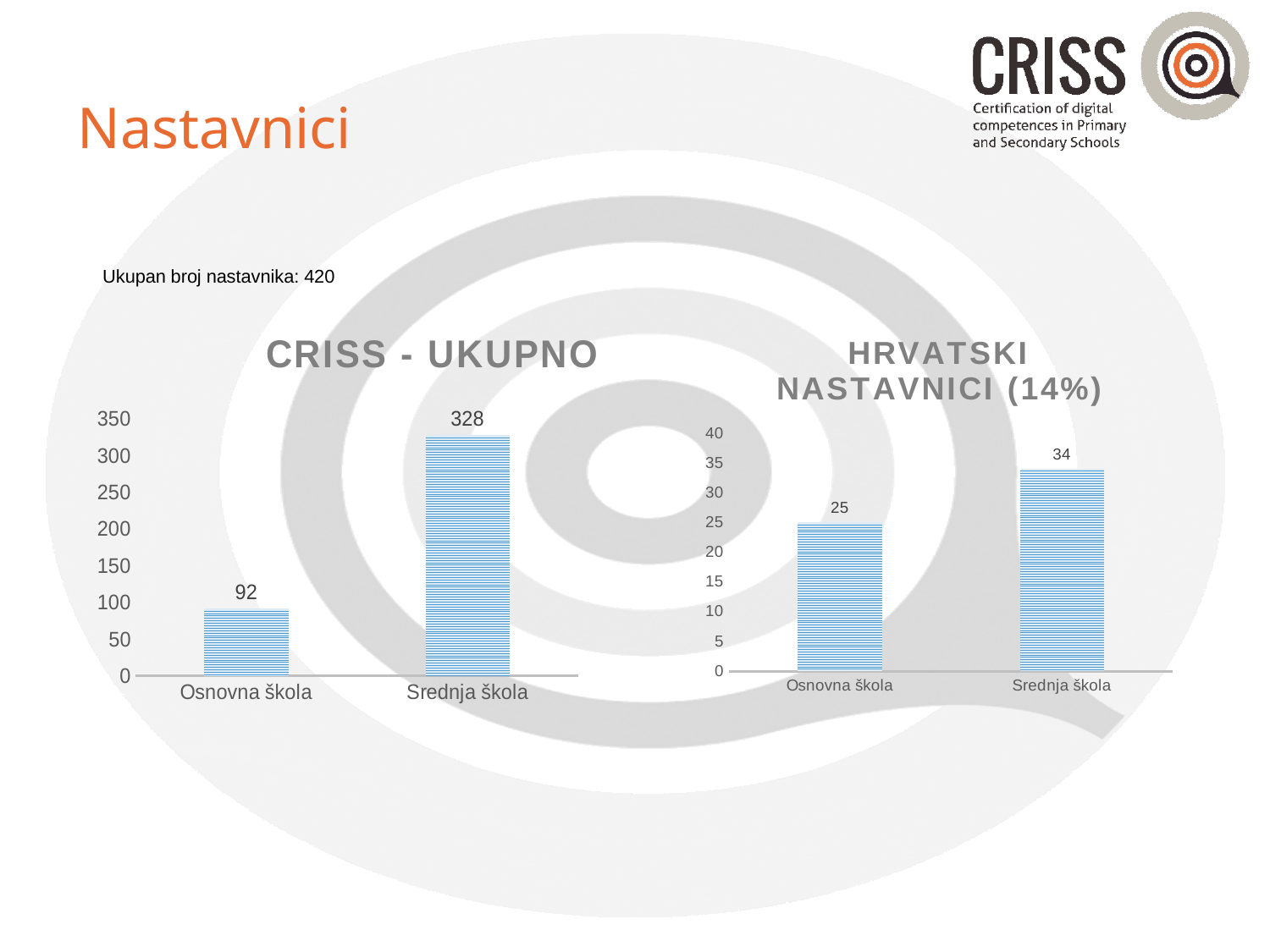
What is the title of the chart on the left side of the slide? CRISS - UKUPNO How many categories does the 'CRISS - UKUPNO' chart show? 2 In the 'CRISS - UKUPNO' chart, what is the value for Osnovna škola? 92 What kind of chart is the 'HRVATSKI NASTAVNICI (14%)' chart? Bar chart In the 'HRVATSKI NASTAVNICI (14%)' chart, which category has the lowest value? Osnovna škola In the 'HRVATSKI NASTAVNICI (14%)' chart, which is larger, the value for Osnovna škola or Srednja škola? Srednja škola In the 'CRISS - UKUPNO' chart, which category has the highest value? Srednja škola In the 'CRISS - UKUPNO' chart, what is the value for Srednja škola? 328 In the 'HRVATSKI NASTAVNICI (14%)' chart, what is the value for Srednja škola? 34 In the 'HRVATSKI NASTAVNICI (14%)' chart, what is the value for Osnovna škola? 25 In the 'CRISS - UKUPNO' chart, what is the difference between the values for Srednja škola and Osnovna škola? 236 In the 'HRVATSKI NASTAVNICI (14%)' chart, what is the difference between the values for Srednja škola and Osnovna škola? 9